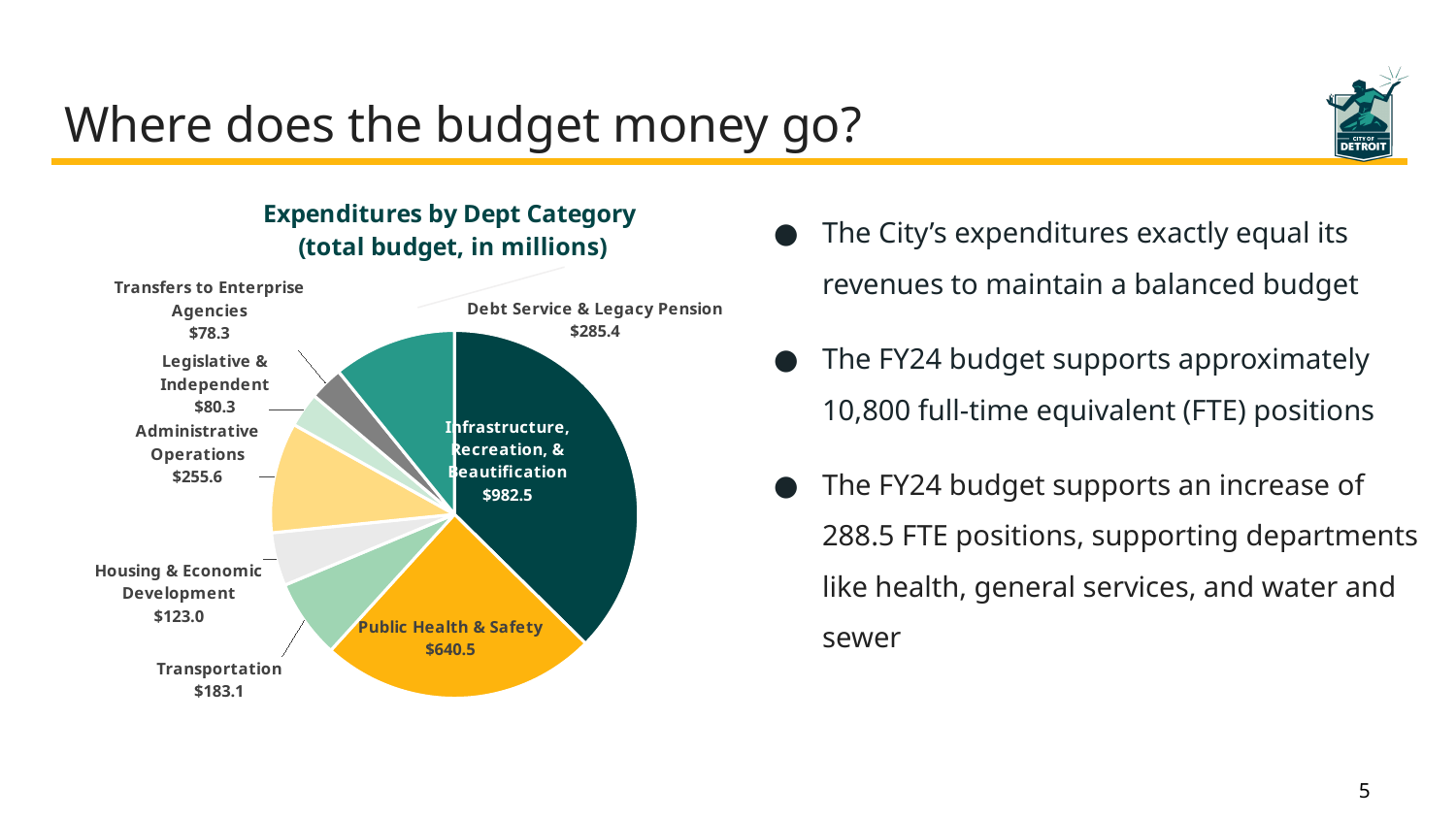
Which is larger, Administrative Operations or Transportation? Administrative Operations What is the difference between Transportation and Housing & Economic Development? $60.1 What is the value for Debt Service & Legacy Pension? $285.4 What is the value for Housing & Economic Development? $123.0 Which category has the smallest expenditure? Transfers to Enterprise Agencies What is the value for Public Health & Safety? $640.5 What is the difference between Infrastructure, Recreation, & Beautification and Public Health & Safety? $342.0 How many department categories are shown in the pie chart? 8 Which category has the largest expenditure? Infrastructure, Recreation, & Beautification What kind of chart is shown on the slide? Pie chart What is the total of all expenditure categories shown in the pie chart? $2,628.7 What is the title of the chart? Expenditures by Dept Category (total budget, in millions)